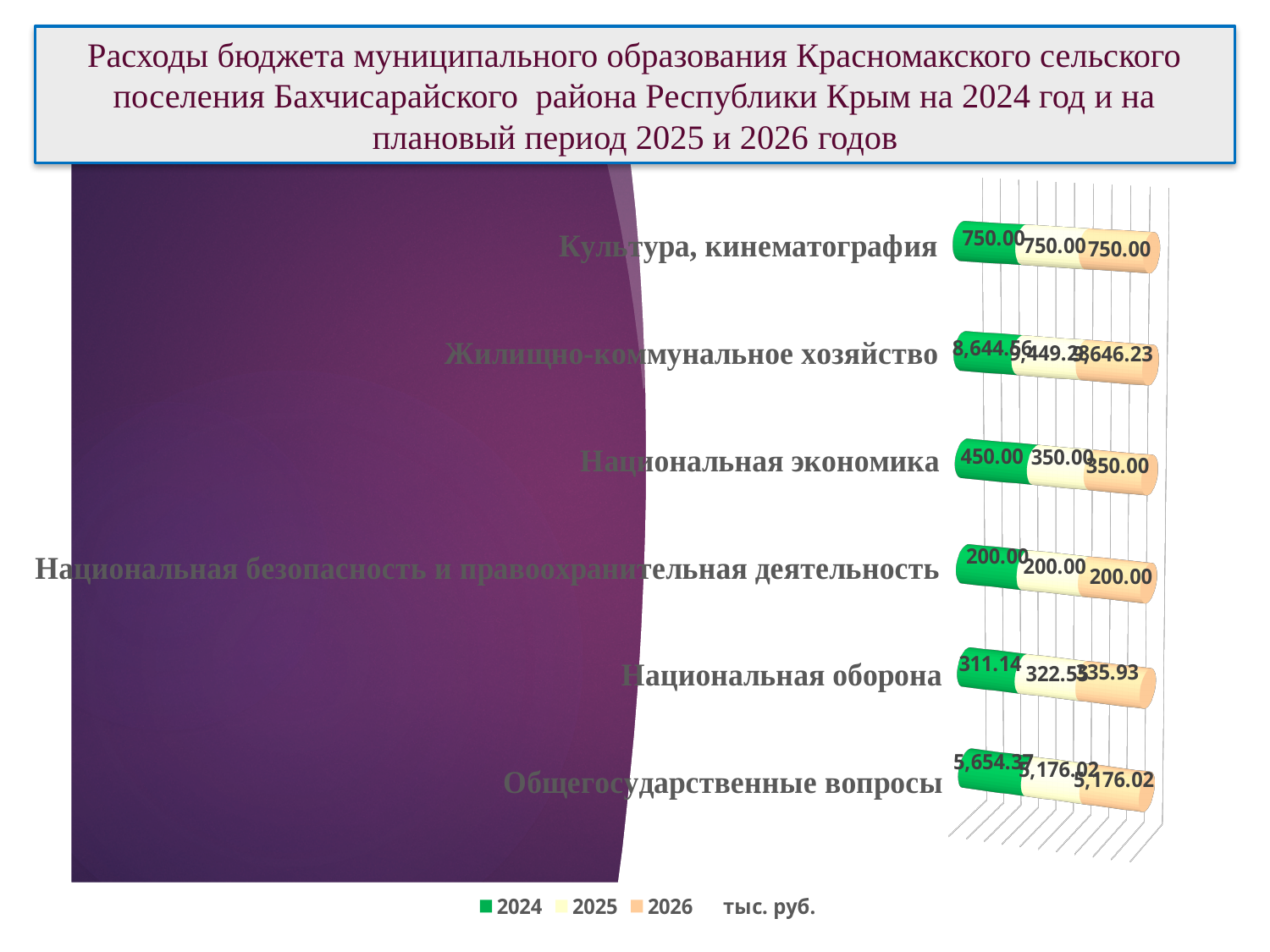
Which category has the lowest 2024 value? Национальная безопасность и правоохранительная деятельность What is the 2024 value for Культура, кинематография? 750.00 What is the difference between the 2024 and 2025 values for Национальная экономика? 100.00 Which category has the highest 2024 value? Жилищно-коммунальное хозяйство What kind of chart is shown on the slide? bar chart For Национальная оборона, which year has the larger value, 2024 or 2026? 2026 Do the values for Национальная оборона rise or fall from 2024 to 2026? rise How many expenditure categories are shown in the chart? 6 What is the 2024 value for Национальная экономика? 450.00 What is the 2025 value for Национальная оборона? 322.55 What is the 2026 value for Национальная оборона? 335.93 How many series does the legend list? 3